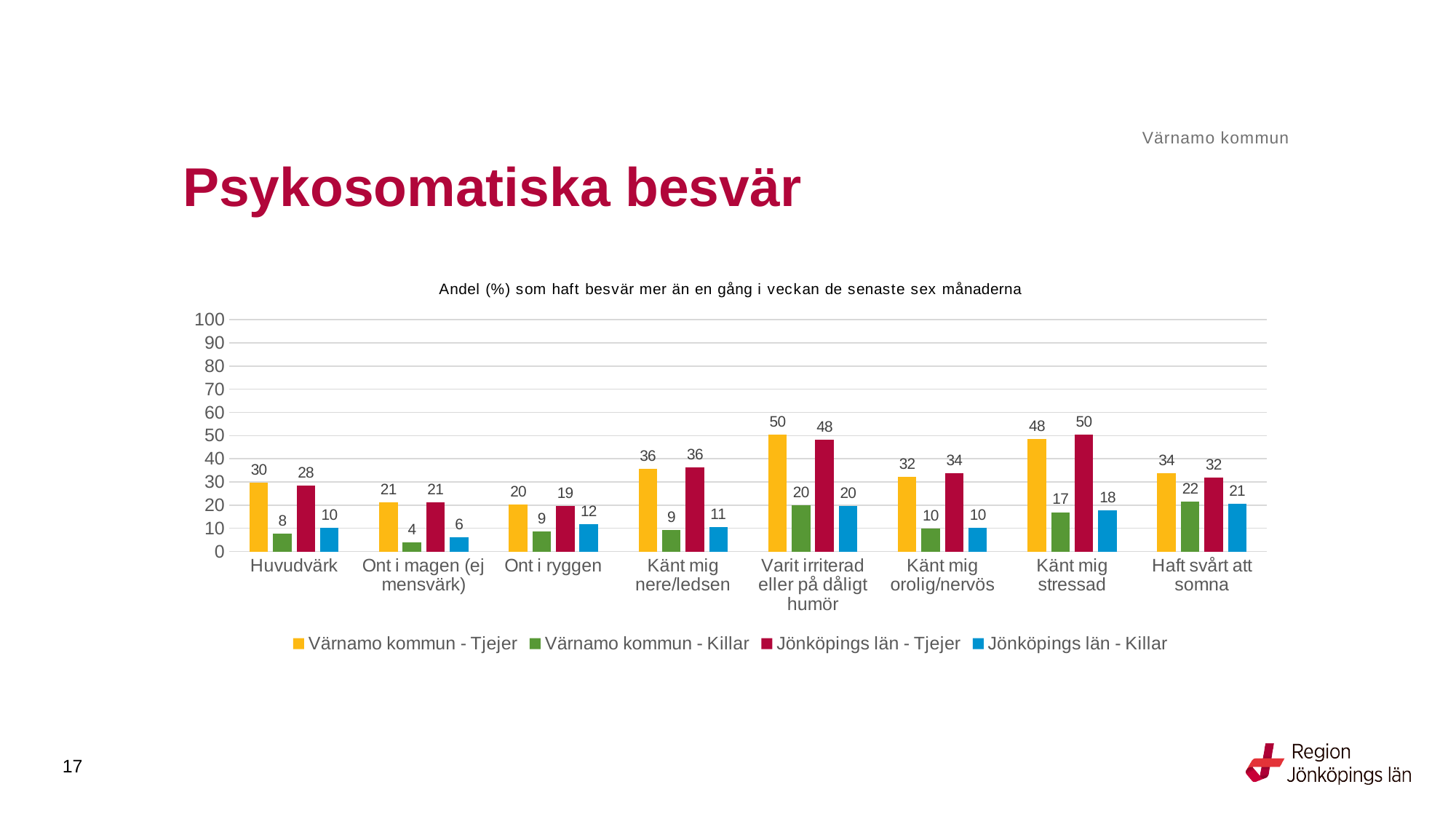
What is the value for Värnamo kommun - Tjejer for Huvudvärk? 30 Which colour represents Jönköpings län - Tjejer in the legend? Red What is the value for Jönköpings län - Killar for Känt mig stressad? 18 What is the difference between Värnamo kommun - Tjejer and Värnamo kommun - Killar for Känt mig nere/ledsen? 27 How many series does the legend list? 4 What is the title of the chart? Andel (%) som haft besvär mer än en gång i veckan de senaste sex månaderna Which category has the highest value for Värnamo kommun - Tjejer? Varit irriterad eller på dåligt humör Which category has the lowest value for Jönköpings län - Killar? Ont i magen (ej mensvärk) What is the value for Värnamo kommun - Killar for Ont i magen (ej mensvärk)? 4 How many categories are shown on the x axis? 8 Which is larger for Haft svårt att somna: Värnamo kommun - Tjejer or Jönköpings län - Tjejer? Värnamo kommun - Tjejer What kind of chart is shown on the slide? Bar chart